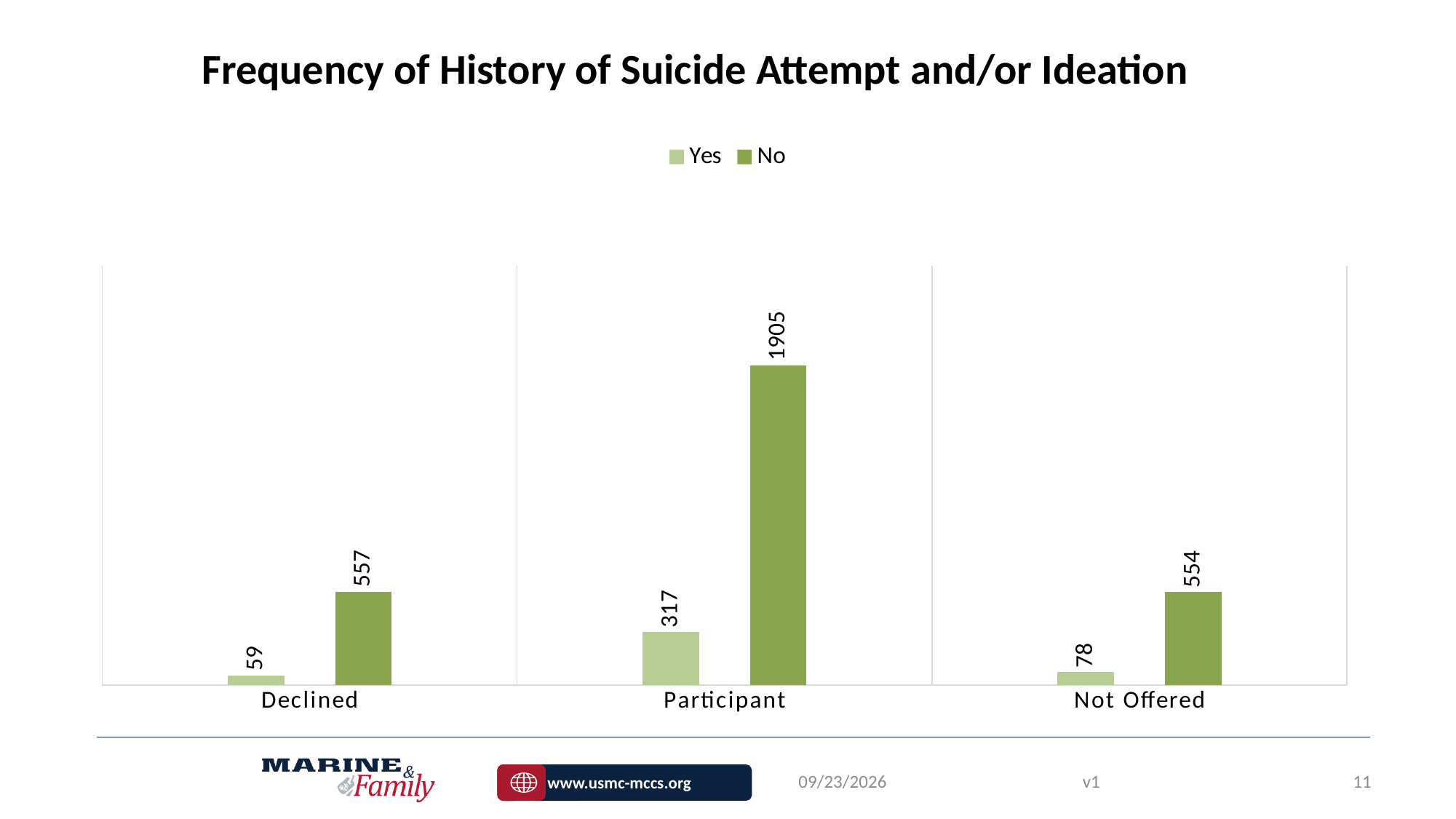
How many categories are shown on the x axis? 3 What is the title of the chart? Frequency of History of Suicide Attempt and/or Ideation What is the value of the Yes series for Participant? 317 What is the value of the Yes series for Not Offered? 78 How many series does the legend list? 2 What kind of chart is shown on the slide? Bar chart Which category has the highest No value? Participant What is the value of the No series for Declined? 557 Which is larger, the Yes value for Participant or the Yes value for Not Offered? Participant Which category has the lowest Yes value? Declined What is the difference between the Yes values for Not Offered and Declined? 19 What is the difference between the No and Yes values for Participant? 1588